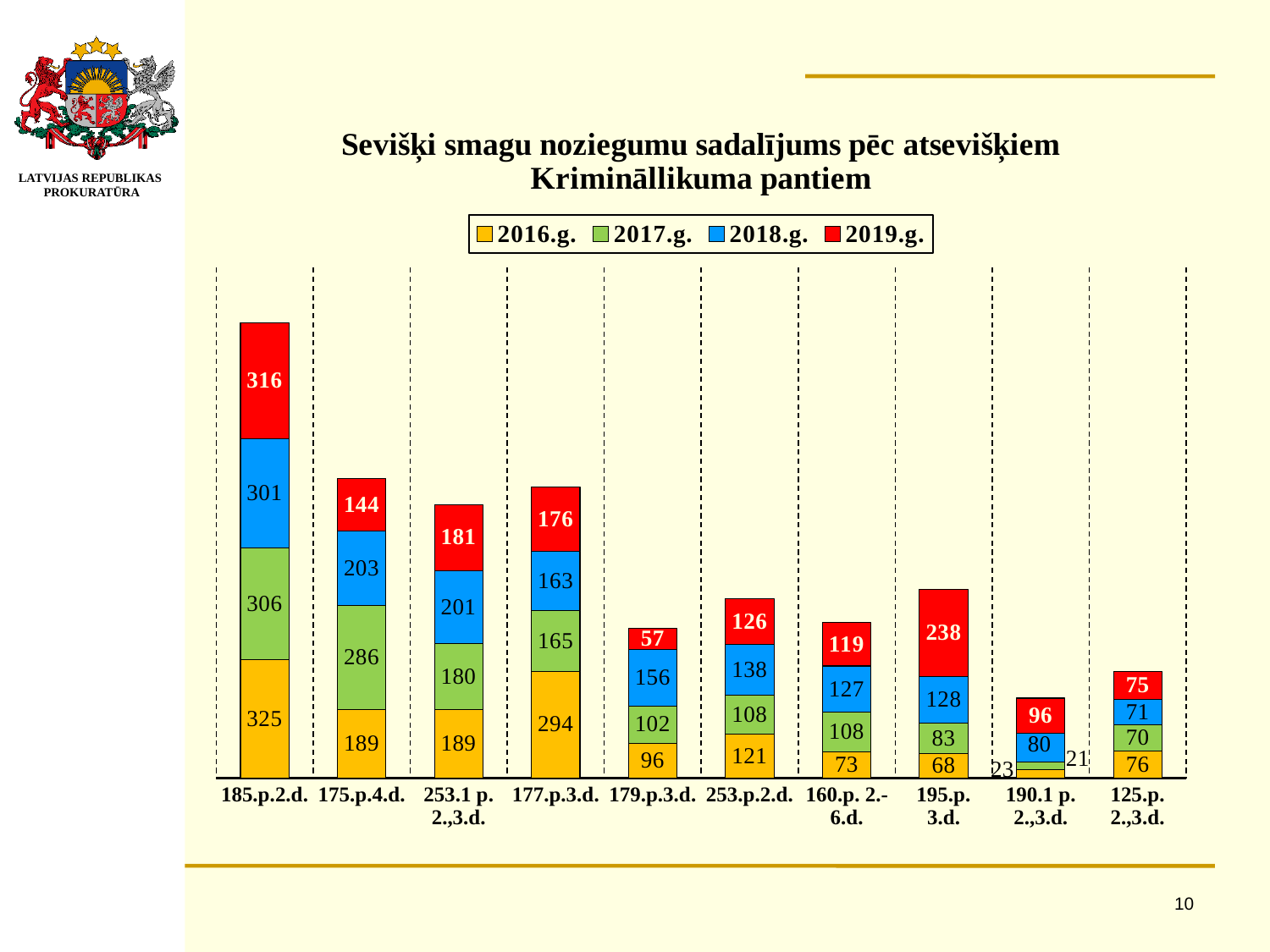
What is the 2016.g. value for 177.p.3.d.? 294 Which category has the tallest stacked bar overall? 185.p.2.d. What is the difference between the 2018.g. and 2016.g. values for 179.p.3.d.? 60 What kind of chart is shown on the slide? Stacked bar chart How many series does the legend list? 4 Which colour represents 2019.g. in the legend? Red Which has the larger 2017.g. value: 175.p.4.d. or 253.1 p. 2.,3.d.? 175.p.4.d. What is the total of the stacked bar for 125.p. 2.,3.d.? 292 What is the 2019.g. value for 195.p. 3.d.? 238 Which category has the lowest 2019.g. value? 179.p.3.d. How many categories (Criminal Law articles) are shown on the x axis? 10 What is the 2018.g. value for 160.p. 2.-6.d.? 127